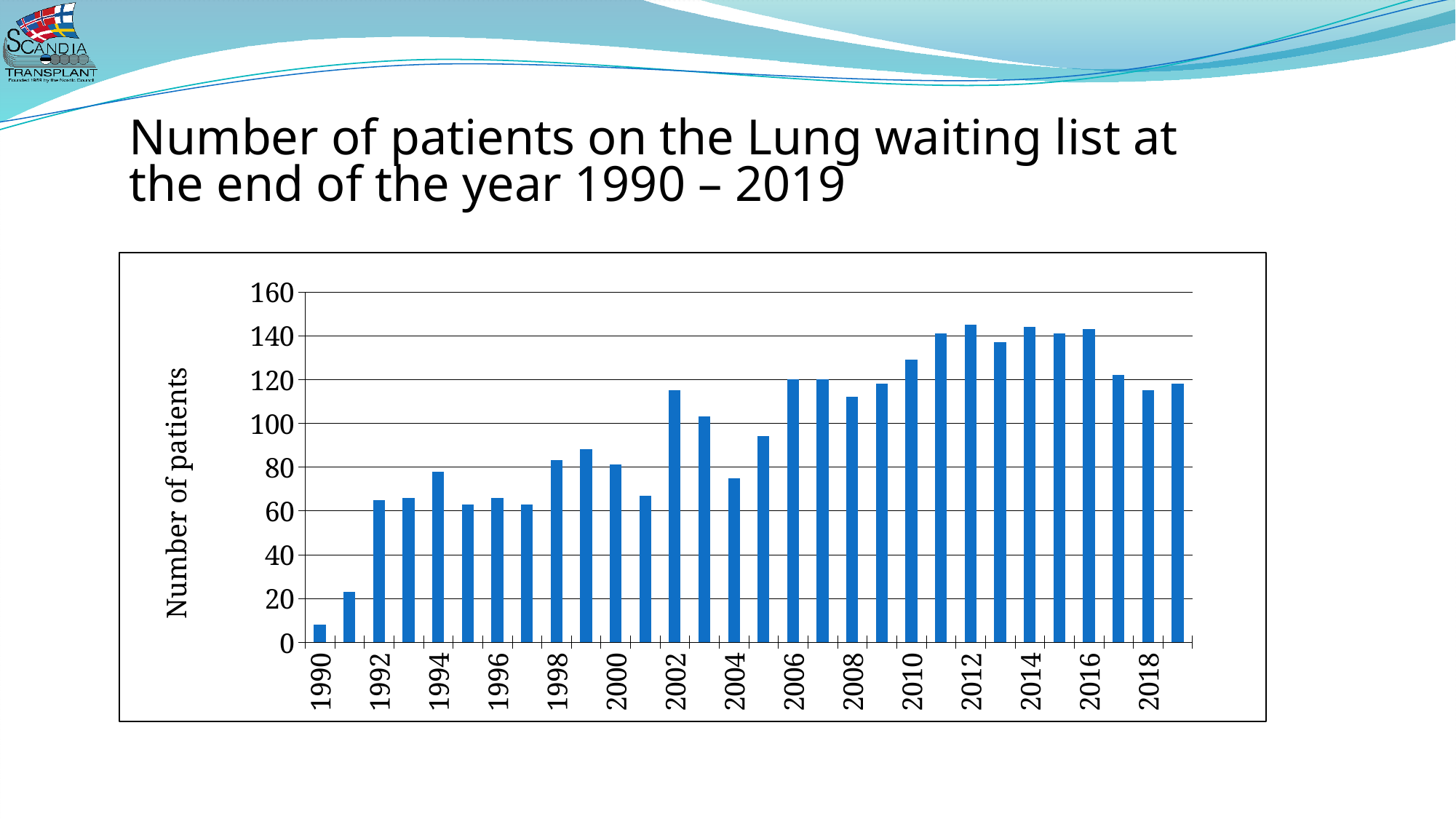
How many years (bars) are plotted in the chart? 30 Is the value for 1990 greater or less than 20? less Is the value for 2012 greater or less than 140? greater Overall, do the values rise or fall from 1990 to 2019? rise Is the value for 2018 greater or less than 120? less Which year has the lowest number of patients on the lung waiting list? 1990 What kind of chart is shown on the slide? bar chart Which is larger, the value for 2002 or the value for 2004? 2002 What is the label on the vertical axis of the chart? Number of patients